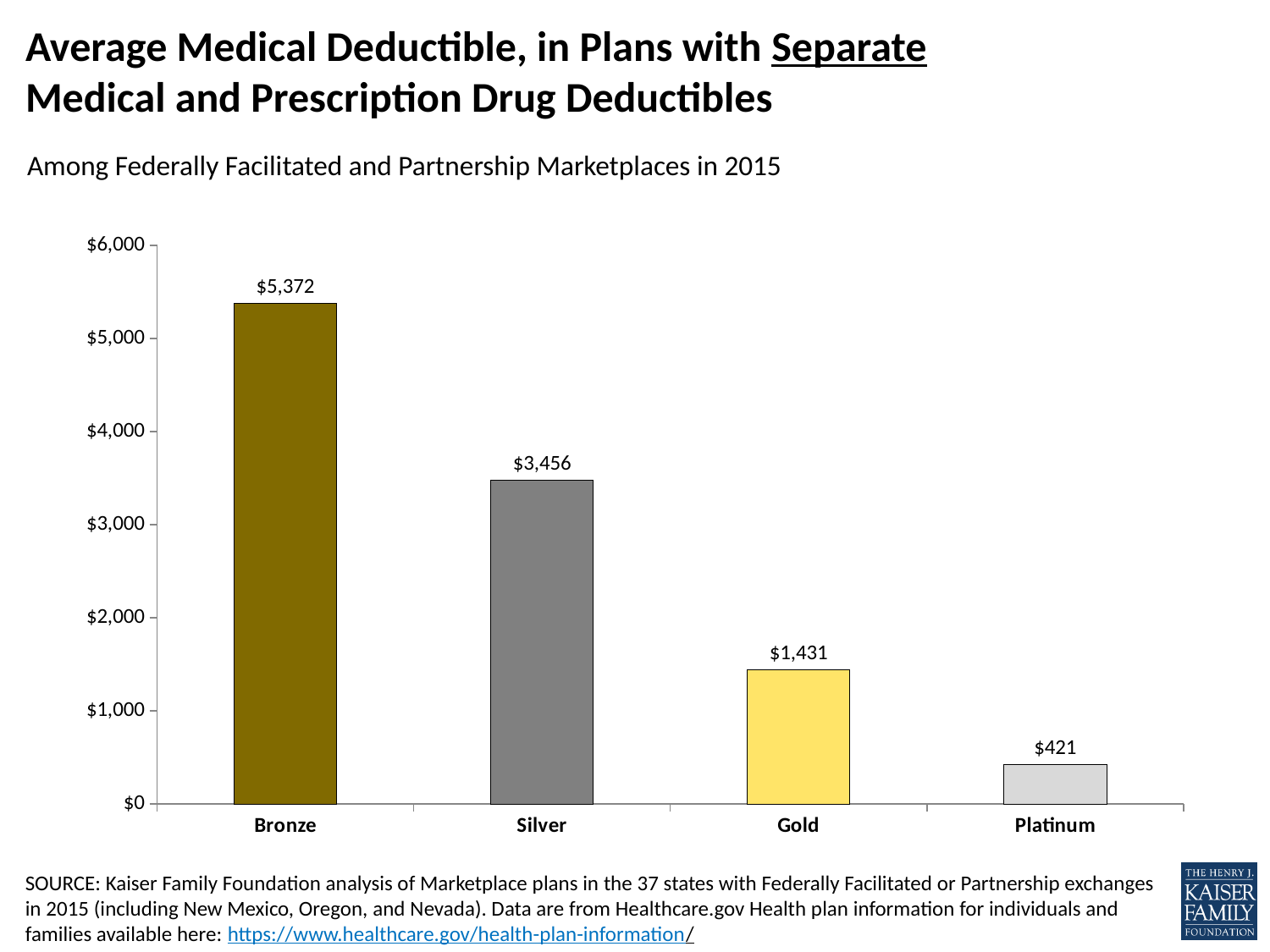
What is the average medical deductible for Silver plans? $3,456 What is the average medical deductible for Platinum plans? $421 What kind of chart is shown on the slide? Bar chart What is the difference between the Bronze and Silver average medical deductibles? $1,916 Which has a larger average medical deductible, Silver or Gold? Silver Do the values rise or fall moving from Bronze to Platinum along the x axis? Fall How many plan tiers are shown in the chart? 4 What is the average medical deductible for Gold plans? $1,431 What is the difference between the Gold and Platinum average medical deductibles? $1,010 What is the average medical deductible for Bronze plans? $5,372 Which plan tier has the highest average medical deductible? Bronze Which plan tier has the lowest average medical deductible? Platinum